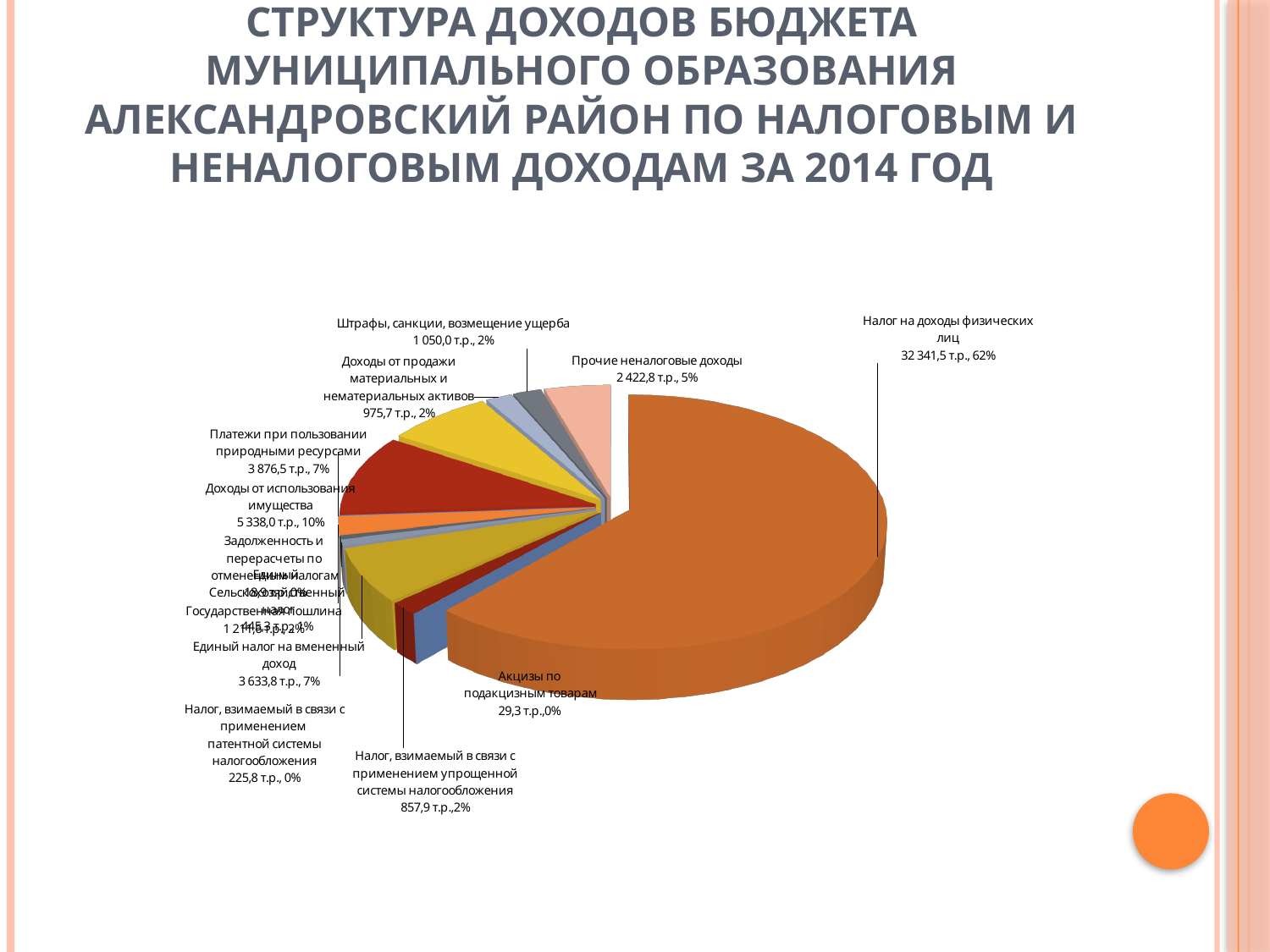
What share of the pie does Доходы от использования имущества represent? 10% What is the difference between Доходы от использования имущества and Платежи при пользовании природными ресурсами? 1 461,5 т.р. What is the value shown for Налог на доходы физических лиц? 32 341,5 т.р. Which is larger: Платежи при пользовании природными ресурсами or Единый налог на вмененный доход? Платежи при пользовании природными ресурсами Which category has the largest share of the pie? Налог на доходы физических лиц What is the value shown for Прочие неналоговые доходы? 2 422,8 т.р. What is the value shown for Акцизы по подакцизным товарам? 29,3 т.р. What share of the pie does Налог, взимаемый в связи с применением упрощенной системы налогообложения represent? 2% What share of the pie does Налог на доходы физических лиц represent? 62% What kind of chart is shown on the slide? Pie chart What is the difference between Штрафы, санкции, возмещение ущерба and Доходы от продажи материальных и нематериальных активов? 74,3 т.р. What is the value shown for Доходы от использования имущества? 5 338,0 т.р.